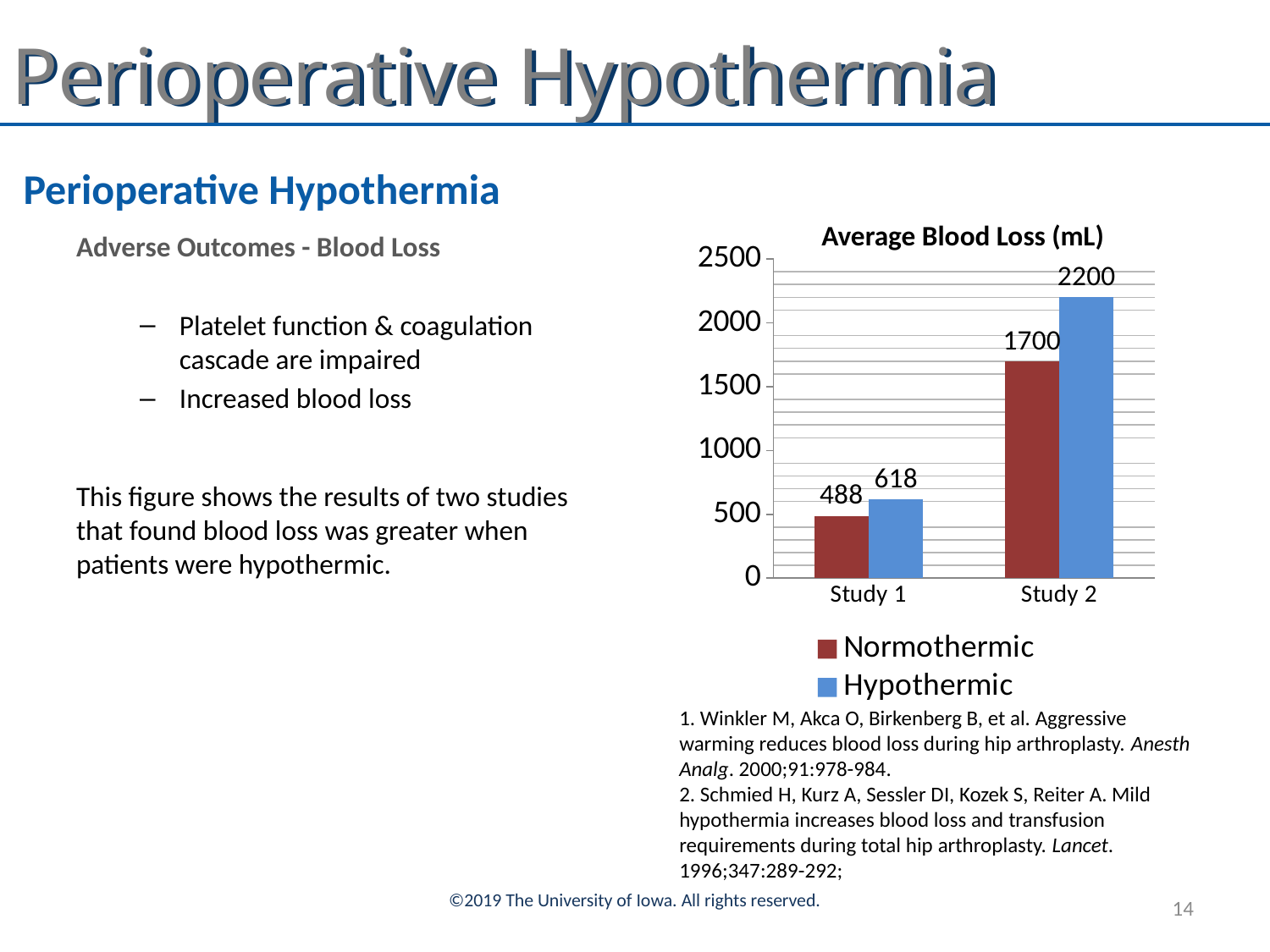
What is the difference between the Hypothermic and Normothermic values in Study 1? 130 What is the average blood loss for the Hypothermic group in Study 1? 618 Which study has the lowest Normothermic blood loss value? Study 1 How many studies are shown on the x axis of the chart? 2 What is the average blood loss for the Hypothermic group in Study 2? 2200 What is the average blood loss for the Normothermic group in Study 2? 1700 What is the title of the chart? Average Blood Loss (mL) In Study 1, which group has the larger blood loss value, Normothermic or Hypothermic? Hypothermic Which study has the highest Hypothermic blood loss value? Study 2 What is the average blood loss for the Normothermic group in Study 1? 488 What is the difference between the Hypothermic and Normothermic values in Study 2? 500 How many series does the chart legend list? 2